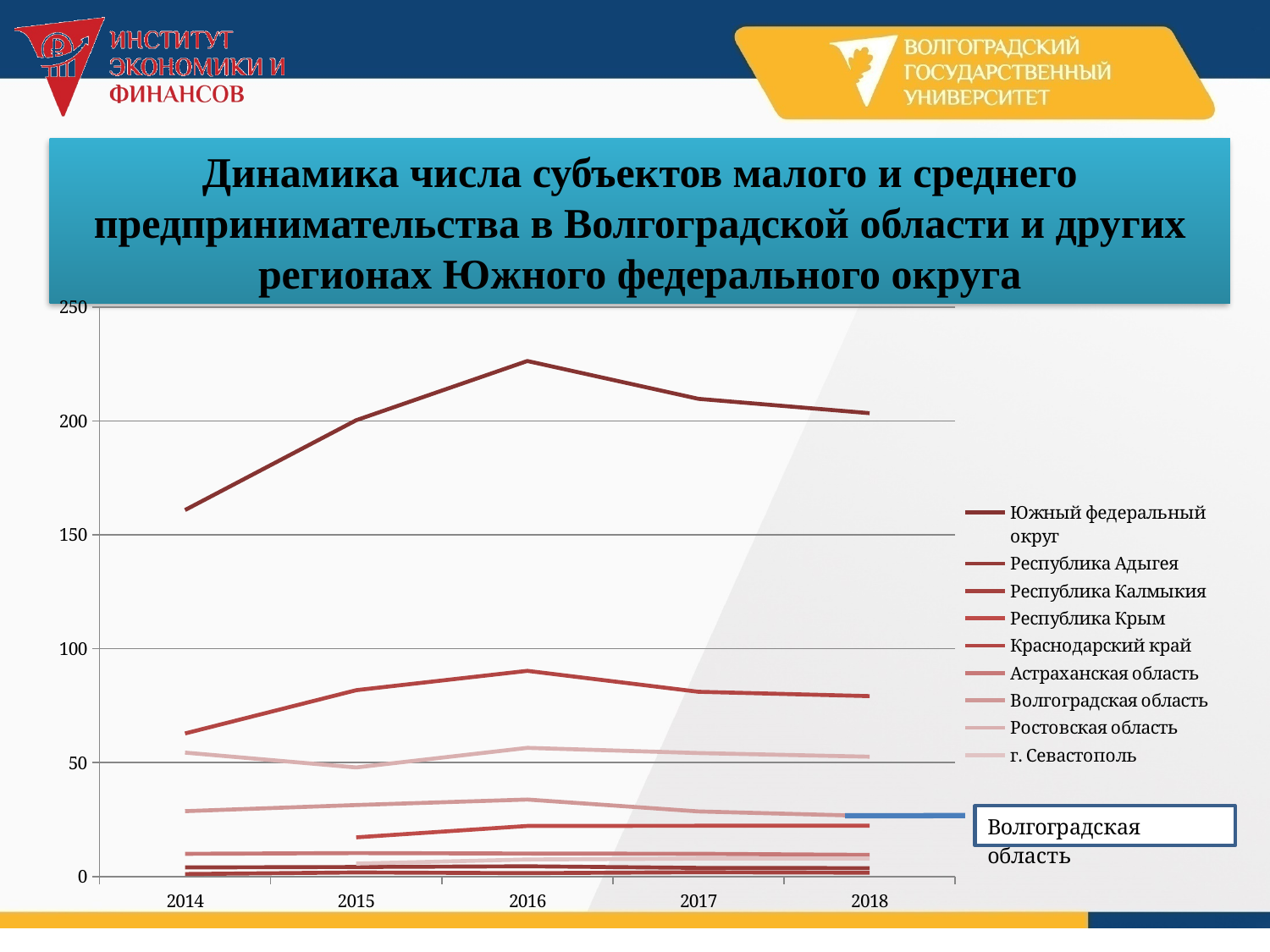
Is the value for Южный федеральный округ in 2016 greater or less than 200? greater Which series has the highest values across all years? Южный федеральный округ What kind of chart is shown on the slide? line chart How many years are shown along the x axis? 5 How many series does the legend list? 9 What is the first year shown on the x axis? 2014 Which is larger for Южный федеральный округ: the value in 2016 or the value in 2018? 2016 In which year is the value for Южный федеральный округ lowest? 2014 Does the line for Южный федеральный округ rise or fall from 2014 to 2016? rise Which region is named in the callout box at the bottom right of the chart? Волгоградская область In which year does the line for Южный федеральный округ reach its highest value? 2016 Is the value for Южный федеральный округ in 2014 greater or less than 200? less